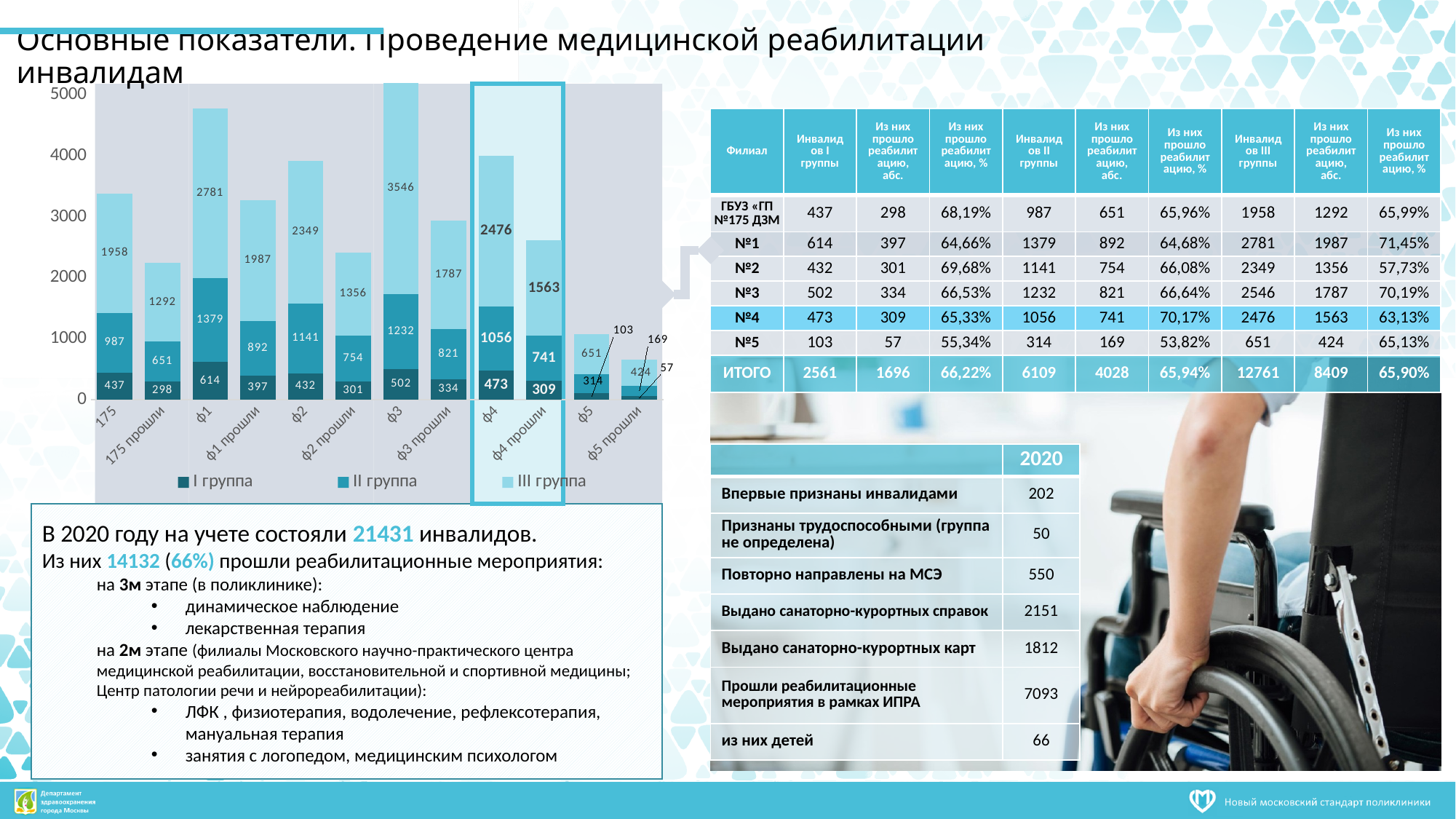
Which is larger: the II группа value for Ф2 or for Ф3? Ф3 What is the difference between the III группа values for Ф1 and Ф1 прошли? 794 What type of chart is shown on the slide? stacked bar chart What is the value of III группа for the category Ф3? 3546 Which category has the lowest value for I группа? Ф5 прошли How many categories are shown along the x axis of the chart? 12 Which category has the highest value for III группа? Ф3 What is the value of I группа for the category Ф4 прошли? 309 Which series is shown in the lightest blue colour in the legend? III группа What is the value of II группа for the category 175? 987 How many series does the chart legend list? 3 What is the total of the stacked bar for the category Ф4? 4005